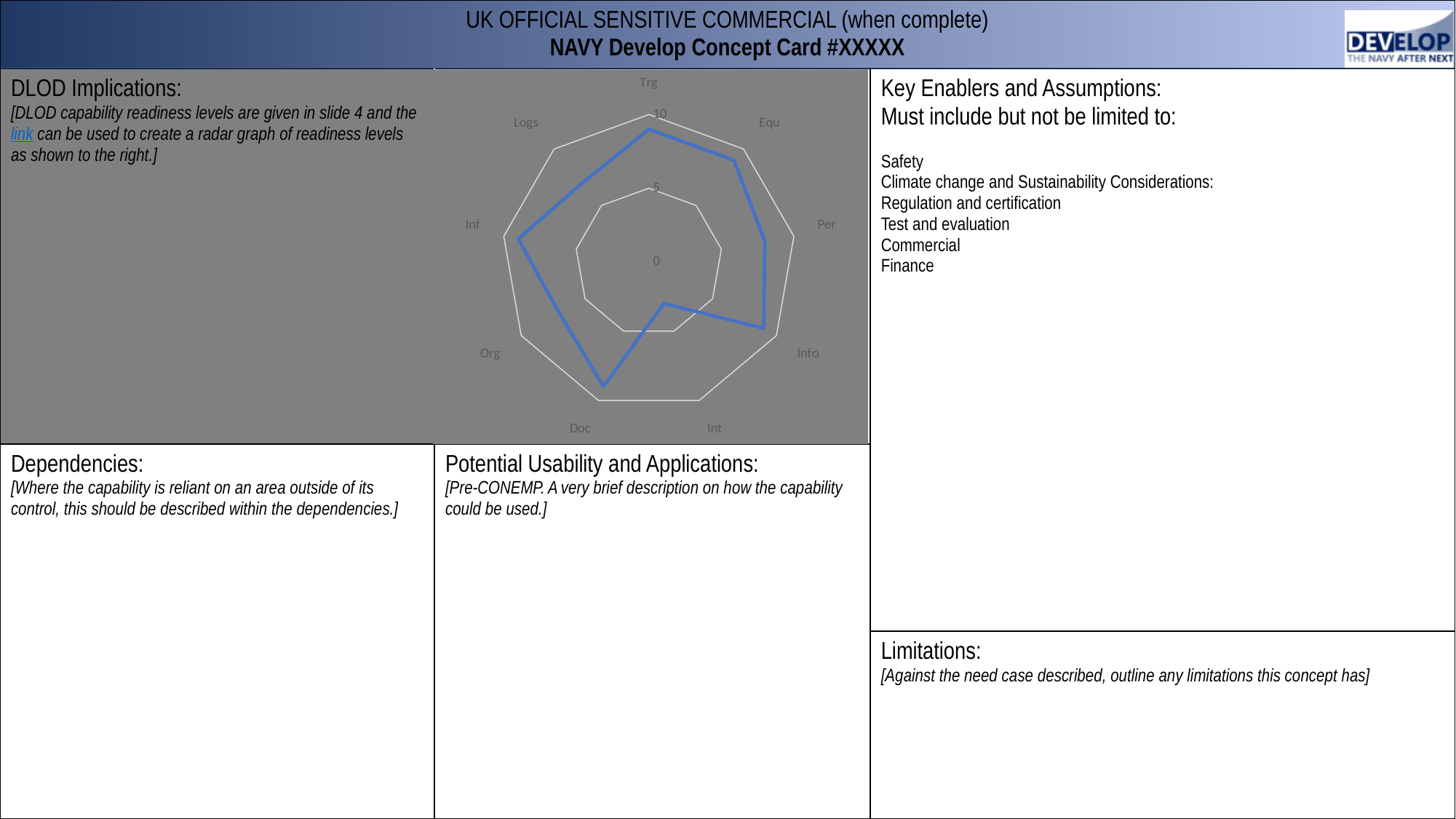
Is the value for Doc greater or less than 5? greater Is the value for Equ greater or less than 5? greater Which is larger, the value for Info or the value for Int? Info What kind of chart is shown on the slide? radar chart Is the value for Inf greater or less than 5? greater What colour is the plotted data line on the radar chart? blue What is the highest tick value shown on the radar chart's scale? 10 How many categories (axes) does the radar chart have? 9 Which category has the lowest value on the radar chart? Int